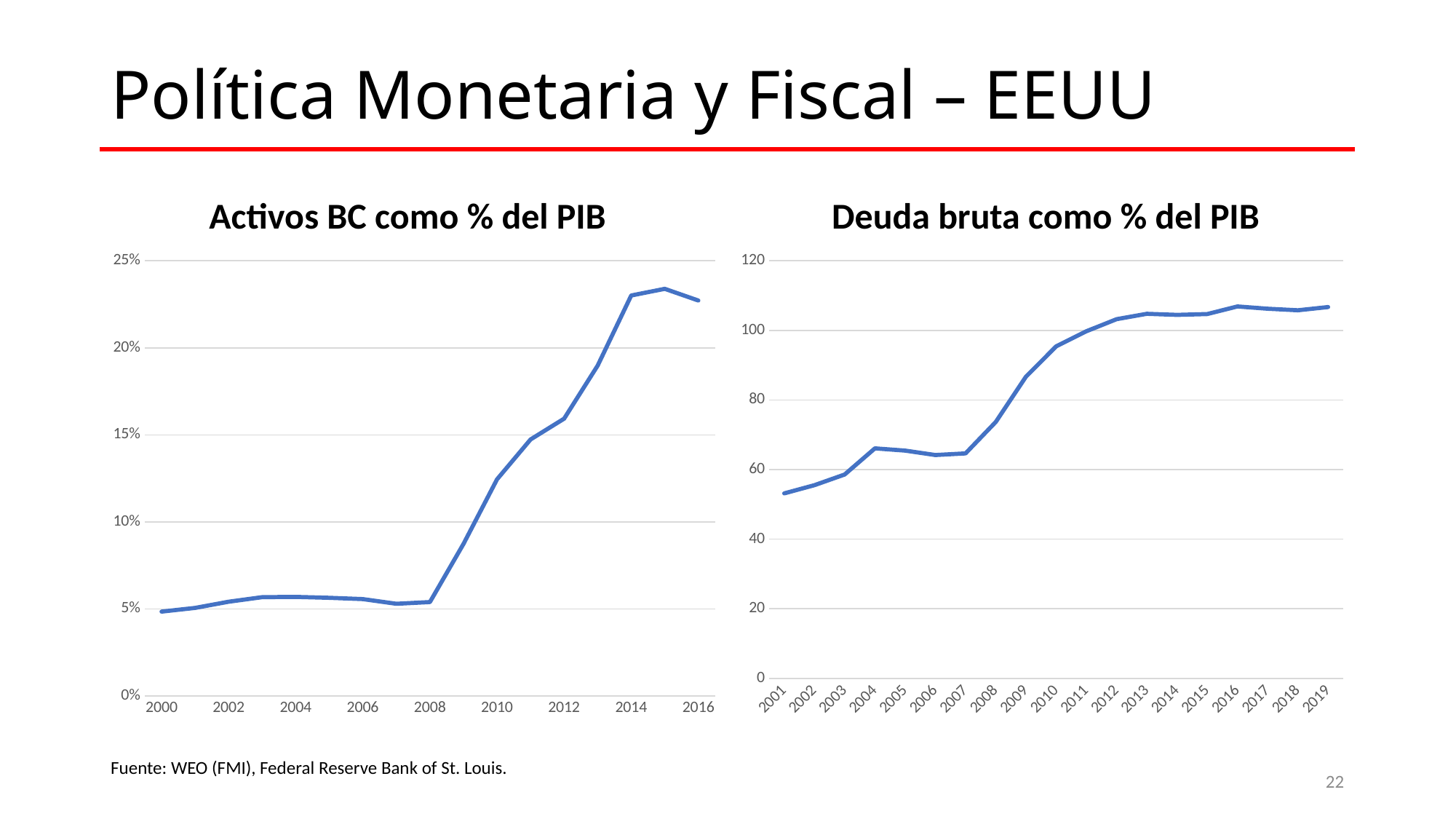
In the "Activos BC como % del PIB" chart, which year has the lowest value? 2000 In the "Deuda bruta como % del PIB" chart, is the value for 2009 greater or less than 80? greater In the "Deuda bruta como % del PIB" chart, how many years are plotted? 19 In the "Deuda bruta como % del PIB" chart, which year has the lowest value? 2001 In the "Activos BC como % del PIB" chart, is the value for 2008 greater or less than 10%? less In the "Deuda bruta como % del PIB" chart, which is larger, the value for 2004 or the value for 2010? 2010 How many charts are on the slide? 2 What kind of chart is "Activos BC como % del PIB"? line chart In the "Activos BC como % del PIB" chart, do values generally rise or fall from 2008 to 2014? rise In the "Activos BC como % del PIB" chart, how many years are plotted? 17 In the "Activos BC como % del PIB" chart, is the value for 2010 greater or less than 10%? greater